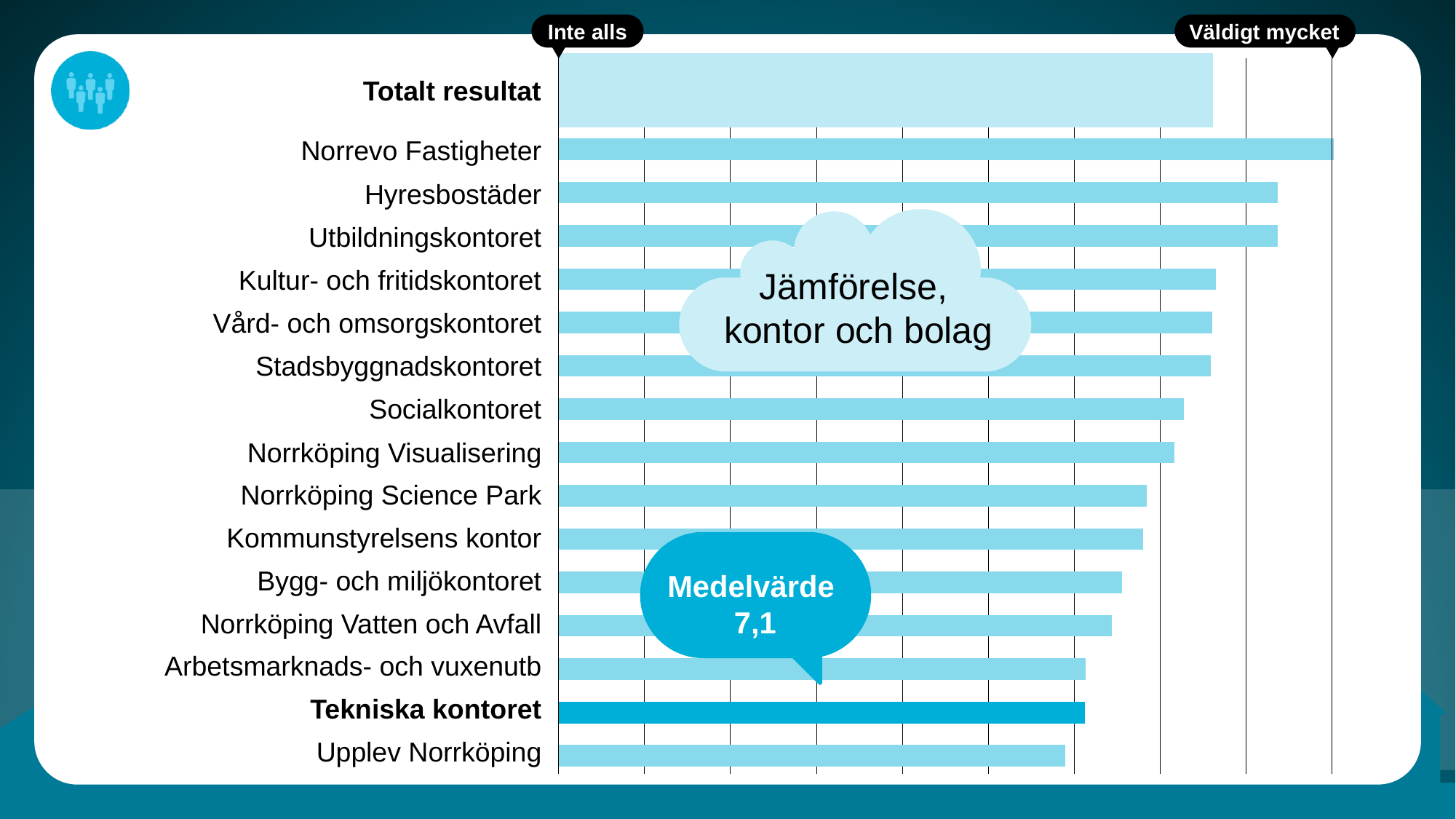
Do the bars for the individual offices and companies get shorter or longer going from top to bottom of the chart? shorter What is the title shown in the cloud on the chart? Jämförelse, kontor och bolag Which has the longer bar, Norrevo Fastigheter or Bygg- och miljökontoret? Norrevo Fastigheter Which category has the longest bar in the chart? Norrevo Fastigheter What mean value (Medelvärde) is shown in the speech bubble on the chart? 7,1 Which category has the shortest bar in the chart? Upplev Norrköping Which has the longer bar, Hyresbostäder or Socialkontoret? Hyresbostäder Which category's bar is highlighted in a darker blue than the others? Tekniska kontoret How many bars are plotted in the chart, including Totalt resultat? 16 Which has the longer bar, Norrköping Science Park or Upplev Norrköping? Norrköping Science Park What are the two labels at the ends of the horizontal axis? Inte alls and Väldigt mycket What kind of chart is shown on the slide? bar chart